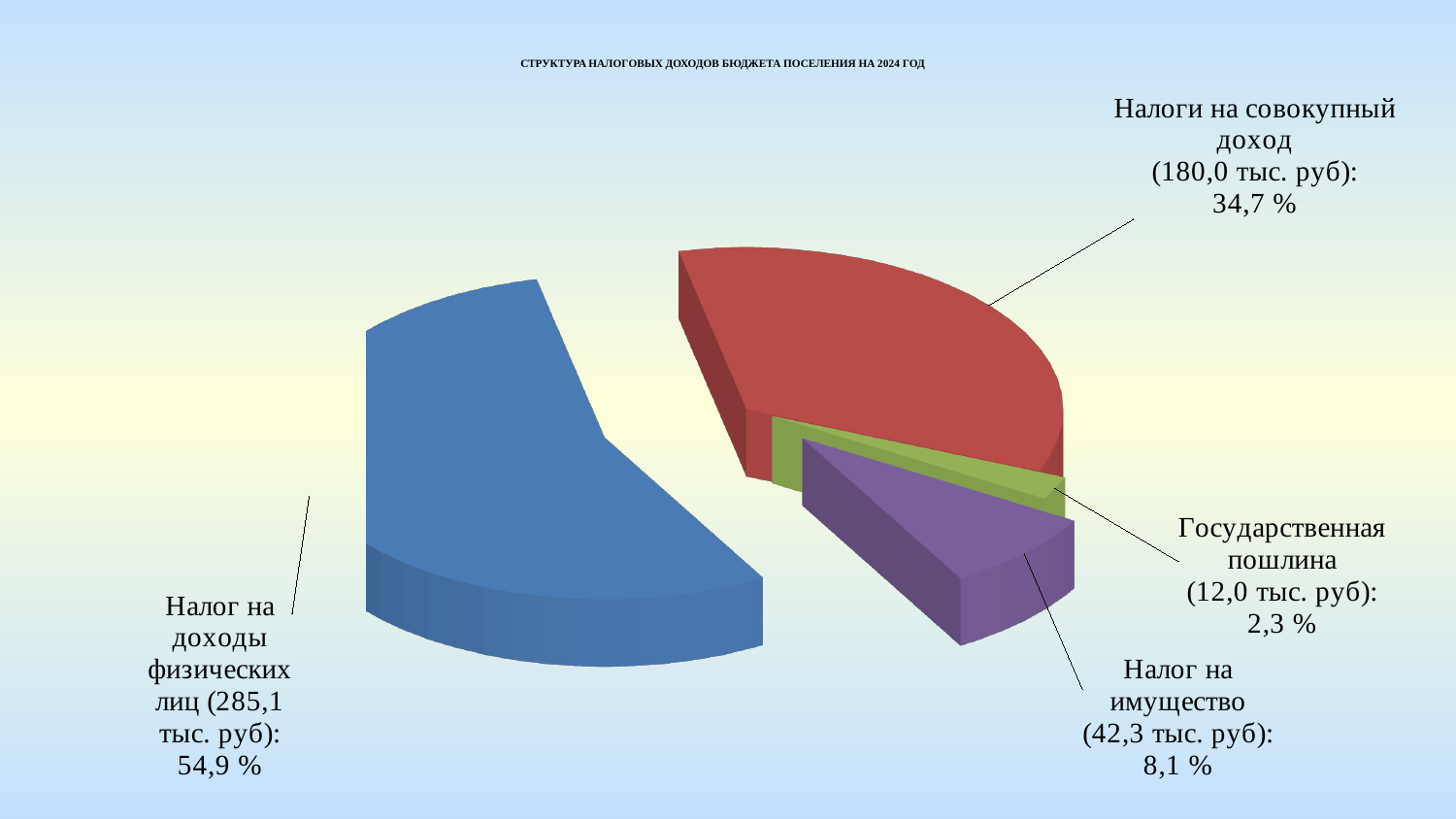
How many slices does the pie chart have? 4 What is the difference in тыс. руб between Налог на доходы физических лиц and Налоги на совокупный доход? 105,1 тыс. руб What is the title of the chart? СТРУКТУРА НАЛОГОВЫХ ДОХОДОВ БЮДЖЕТА ПОСЕЛЕНИЯ НА 2024 ГОД Which is larger: Налог на имущество or Государственная пошлина? Налог на имущество What share of the pie does Государственная пошлина represent? 2,3 % What share of the pie does Налог на доходы физических лиц represent? 54,9 % What colour is the slice for Налог на имущество? Purple Which category has the smallest slice of the pie? Государственная пошлина What is the value in тыс. руб for Налог на имущество? 42,3 тыс. руб What type of chart is shown on the slide? Pie chart Which category has the largest slice of the pie? Налог на доходы физических лиц What is the value in тыс. руб for Налоги на совокупный доход? 180,0 тыс. руб